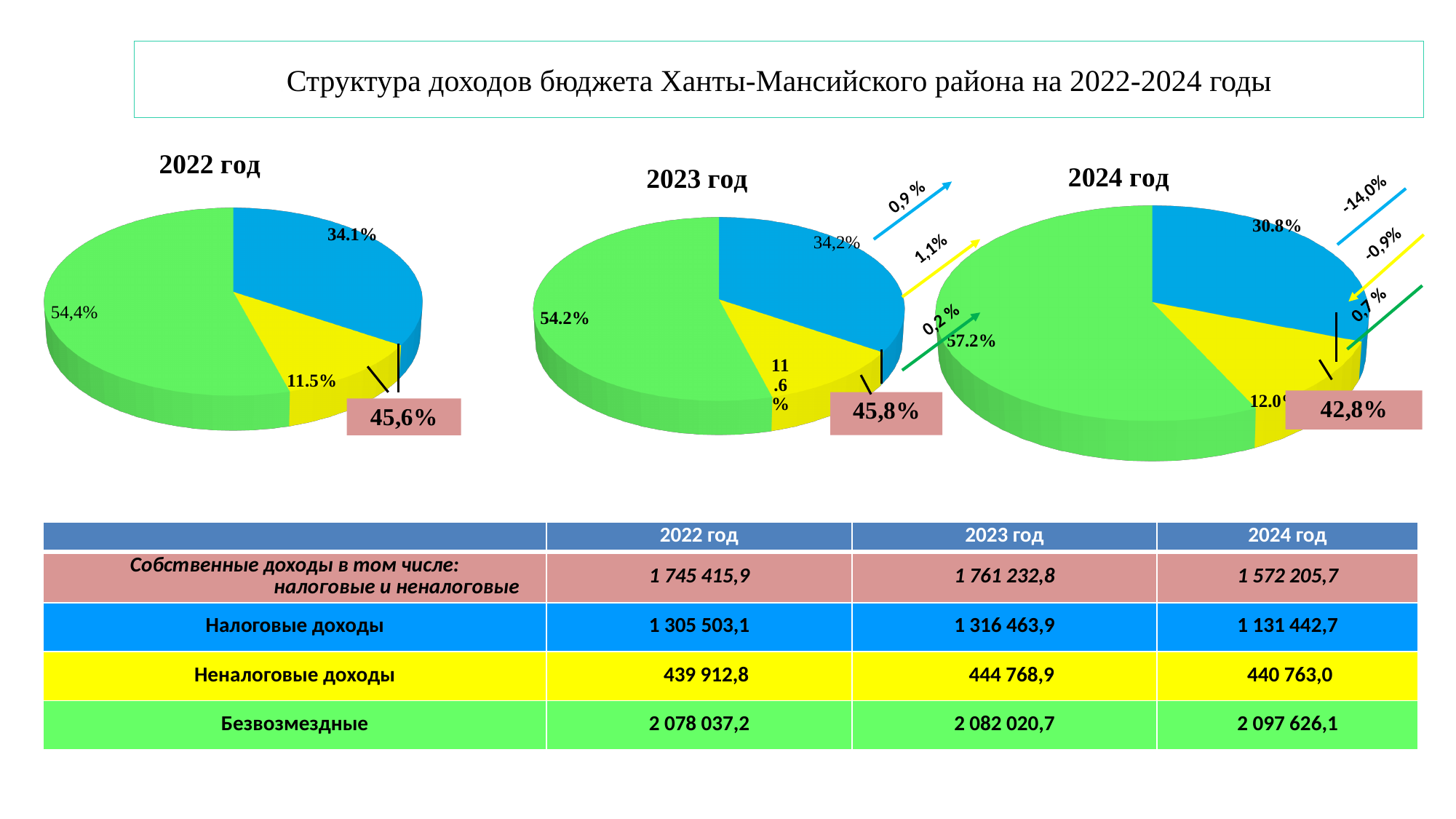
What kind of chart is used for each year on the slide? pie chart How many pie charts are on the slide? 3 In the 2022 год pie chart, what percentage is shown for the green slice? 54,4% In the 2023 год pie chart, what percentage is shown for the green slice? 54.2% In the 2023 год pie chart, what percentage is shown for the blue slice? 34,2% In the 2024 год pie chart, what percentage is shown for the blue slice? 30.8% In the 2023 год pie chart, which slice is the smallest? yellow (11.6%) In the 2024 год pie chart, which slice is the largest? green (57.2%) In the 2022 год pie chart, what percentage is shown for the yellow slice? 11.5% What is the difference between the green slice in the 2024 год chart (57.2%) and the green slice in the 2023 год chart (54.2%)? 3 percentage points In the 2022 год pie chart, what percentage is shown for the blue slice? 34.1% In the 2024 год pie chart, what percentage is shown for the green slice? 57.2%